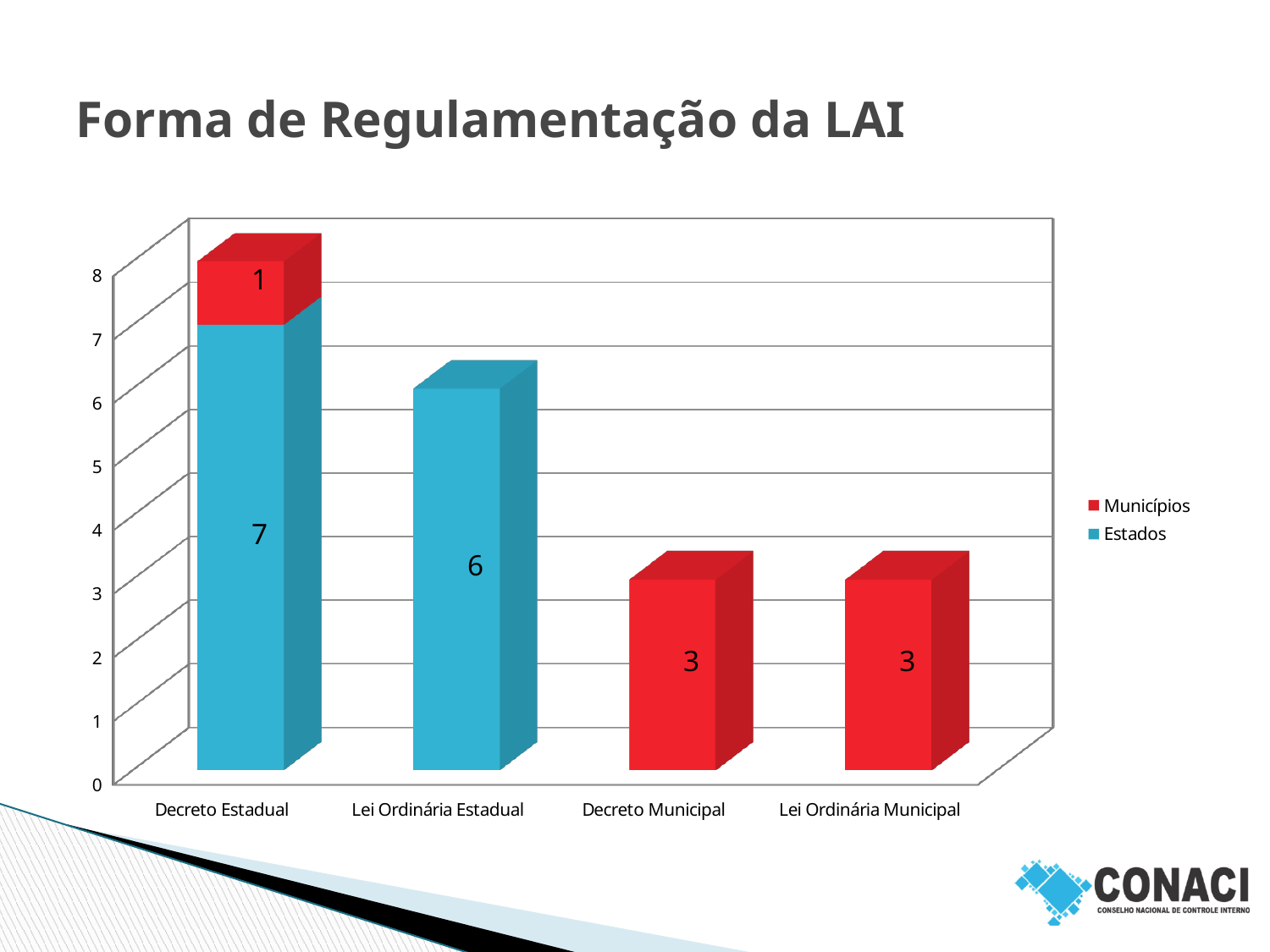
What is the Estados value for Lei Ordinária Estadual? 6 How many categories are shown on the x axis? 4 What is the Municípios value for Decreto Municipal? 3 Which is larger: the Estados value for Lei Ordinária Estadual or the Municípios value for Decreto Municipal? Lei Ordinária Estadual What is the Estados value for Decreto Estadual? 7 What kind of chart is shown on the slide? Bar chart Which category has the tallest bar? Decreto Estadual What is the total of the stacked bar for Decreto Estadual? 8 What is the title of the slide? Forma de Regulamentação da LAI How many series does the legend list? 2 What is the Municípios value for Decreto Estadual? 1 What is the difference between the Estados values for Decreto Estadual and Lei Ordinária Estadual? 1